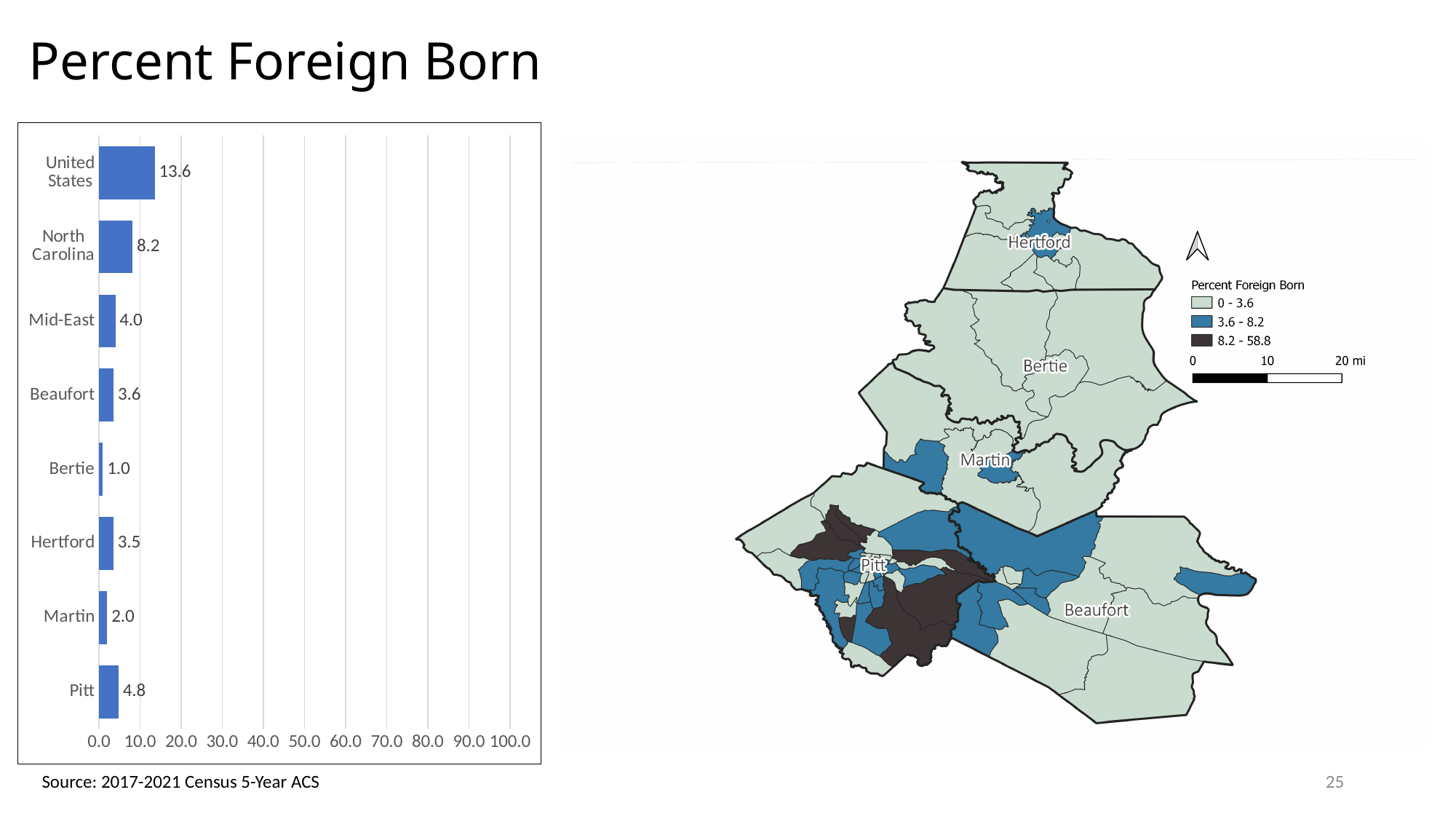
In the bar chart, is the value for the United States greater or less than 10.0? greater In the bar chart, which category has the highest percent foreign born? United States In the bar chart, what is the percent foreign born for the United States? 13.6 In the bar chart, what is the percent foreign born for Pitt? 4.8 In the bar chart, what is the percent foreign born for Bertie? 1.0 In the bar chart, which category has the lowest percent foreign born? Bertie In the bar chart, what is the difference between the Pitt and Martin values? 2.8 In the bar chart, what is the percent foreign born for North Carolina? 8.2 How many categories are shown in the bar chart? 8 In the bar chart, which is larger, the value for Pitt or the value for Mid-East? Pitt In the bar chart, what is the difference between the United States and North Carolina values? 5.4 What kind of chart is shown on the left of the slide? Bar chart